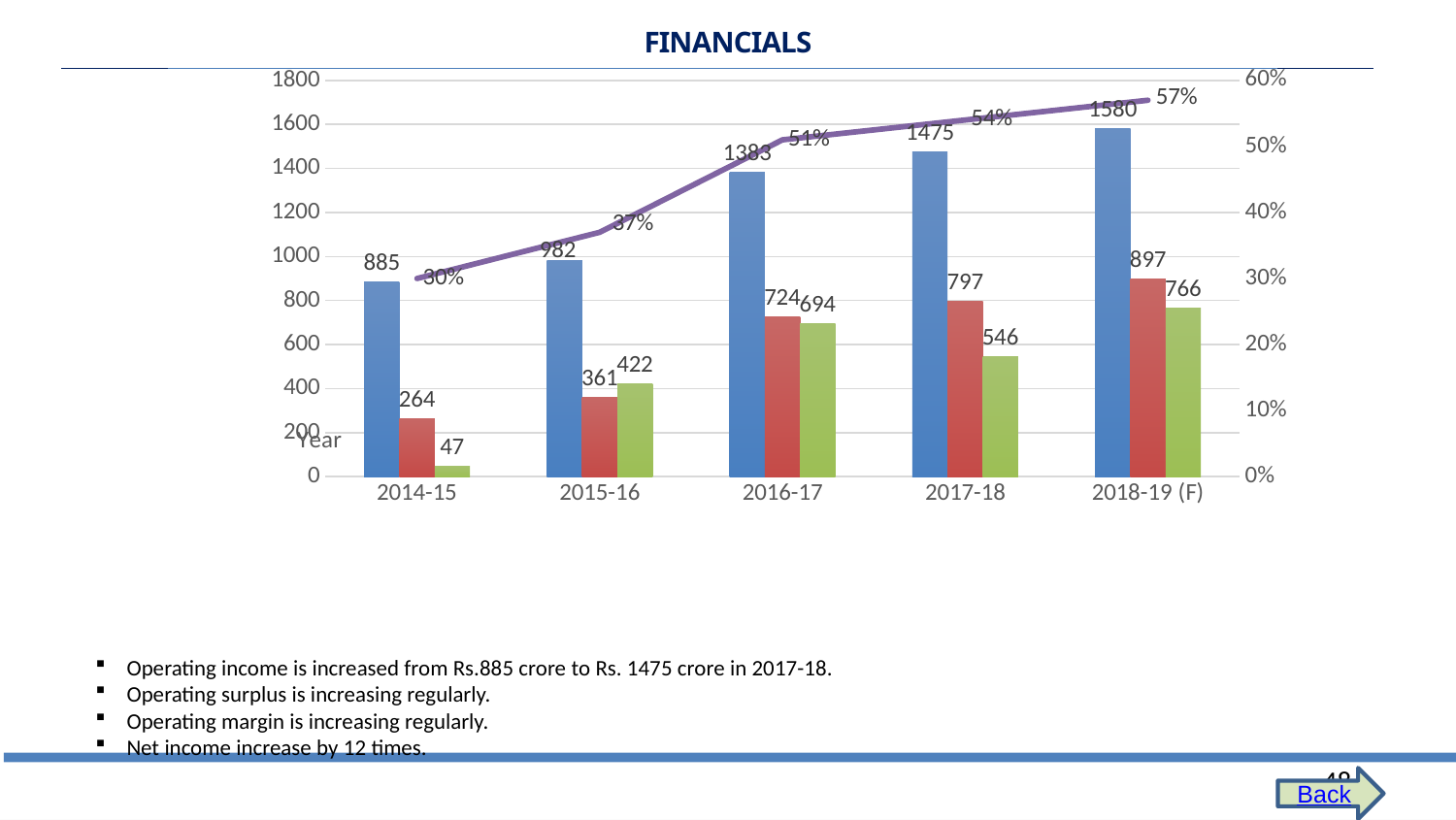
Which year has the larger green bar, 2016-17 or 2017-18? 2016-17 What percentage does the purple line show for 2017-18? 54% What kind of chart is shown on the slide? Bar chart with a line In which year is the green bar lowest? 2014-15 By how much does the blue bar value for 2018-19 (F) exceed the blue bar value for 2014-15? 695 What is the value of the red bar for 2015-16? 361 What is the difference between the red bar values for 2017-18 and 2016-17? 73 Does the purple line rise or fall from 2014-15 to 2018-19 (F)? Rises What is the value of the blue bar for 2016-17? 1383 In which year is the blue bar highest? 2018-19 (F) What is the value of the green bar for 2014-15? 47 How many years are shown on the x axis? 5